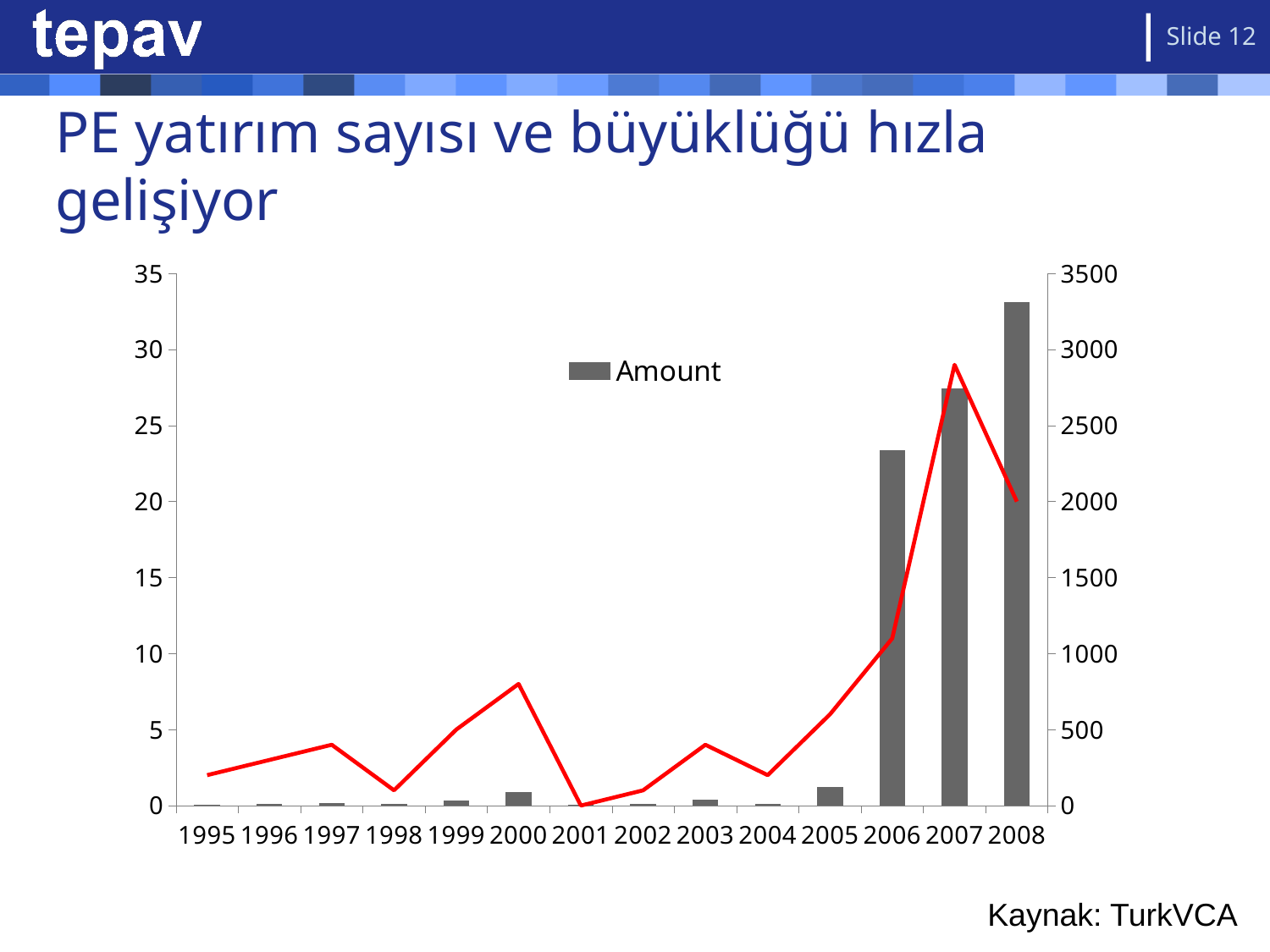
What kind of chart is shown on the slide? A combined bar and line chart Is the Amount bar for 2007 greater or less than 2500 on the right axis? greater How many series does the legend list? 1 Is the red line value for 2008 greater or less than 25 on the left axis? less Is the red line value for 2007 greater or less than 25 on the left axis? greater How many years are shown on the x axis? 14 Which year has the larger Amount bar, 2007 or 2008? 2008 In which year does the red line reach its lowest point? 2001 In which year does the red line reach its highest point? 2007 Which year has the tallest Amount bar? 2008